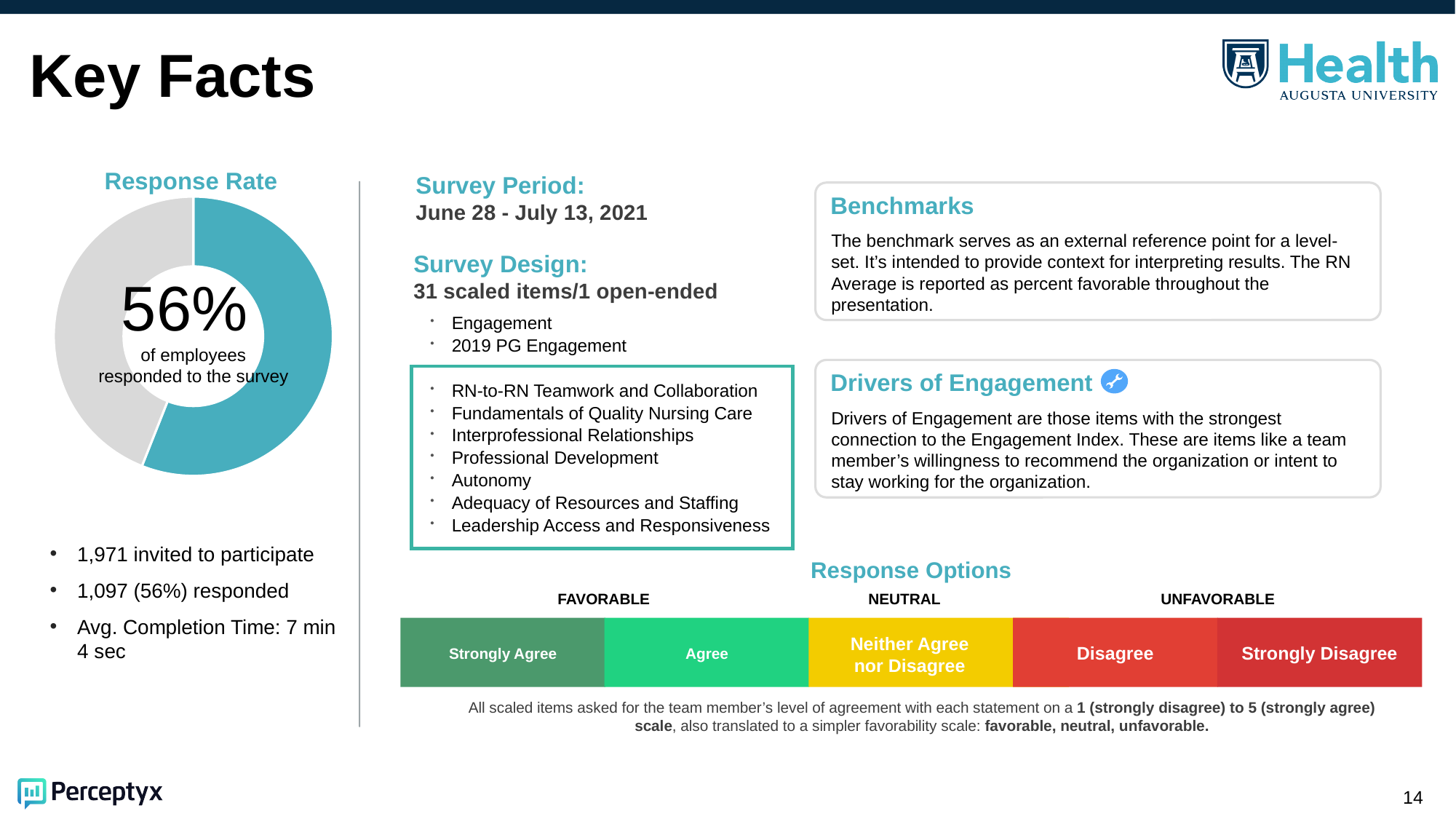
According to the Response Rate chart, what percentage of employees responded to the survey? 56% What kind of chart is shown under the 'Response Rate' heading? Donut (pie) chart What colour is the segment representing employees who responded in the Response Rate chart? Teal In the Response Rate chart, is the share of employees who responded greater or less than 50%? greater In the Response Rate chart, which segment is larger: the teal (responded) segment or the gray segment? The teal (responded) segment What text is printed in the center of the Response Rate donut chart? 56% of employees responded to the survey What share of the Response Rate donut does the teal segment represent? 56% How many segments does the Response Rate donut chart have? 2 What is the title of the donut chart on the left of the slide? Response Rate In the Response Rate chart, is the gray (did not respond) segment greater or less than 50% of the donut? less